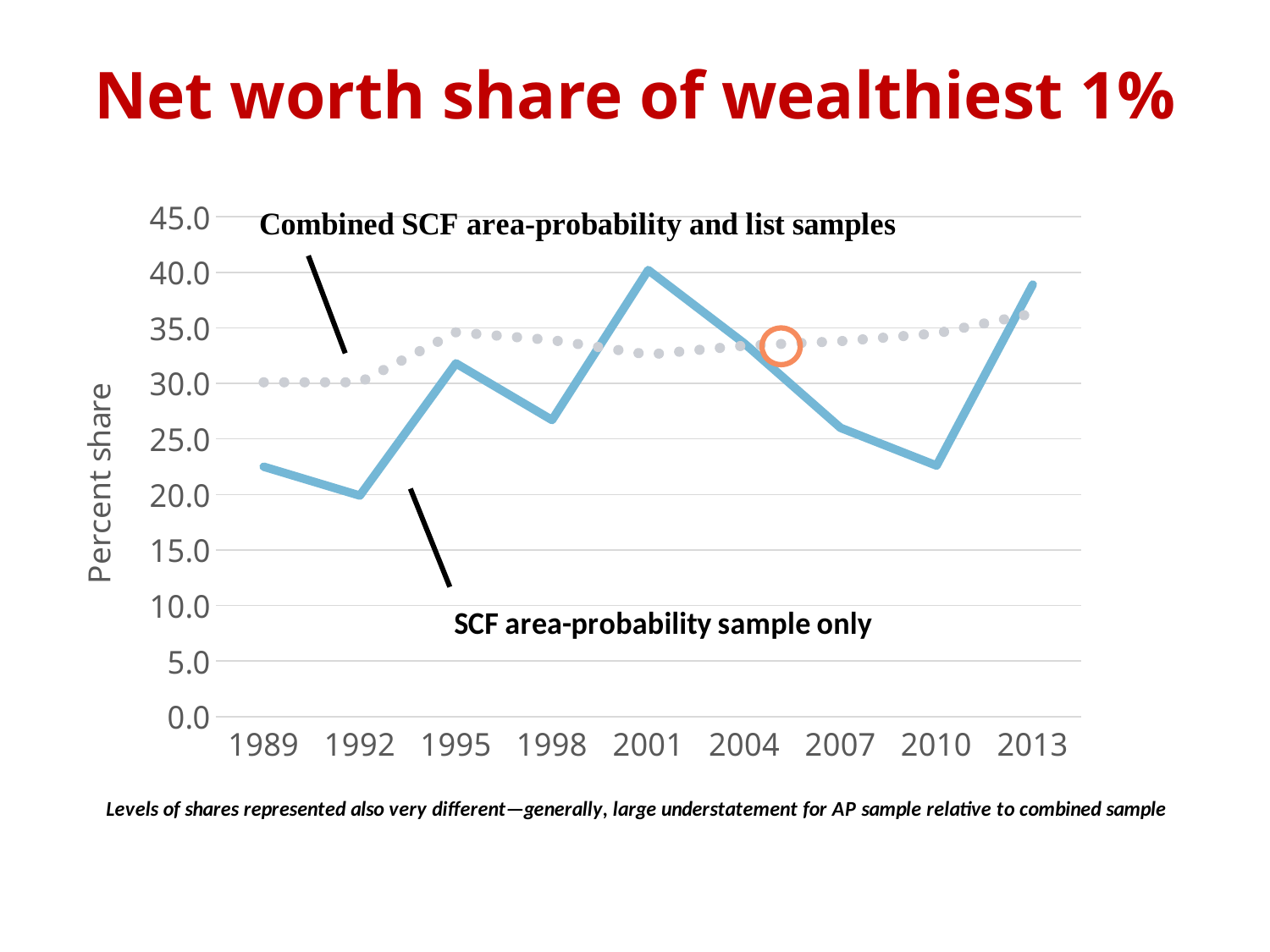
What is the title of the chart? Net worth share of wealthiest 1% What is the label on the vertical axis? Percent share What kind of chart is shown on the slide? line chart How many data series are plotted on the chart? 2 In which year does the 'SCF area-probability sample only' series reach its lowest value? 1992 How many years are plotted along the x axis? 9 In 2010, which series has the higher value: 'Combined SCF area-probability and list samples' or 'SCF area-probability sample only'? Combined SCF area-probability and list samples Is the value for the 'SCF area-probability sample only' series in 1992 greater or less than 25.0? less In which year does the 'Combined SCF area-probability and list samples' series reach its highest value? 2013 Is the value for the 'SCF area-probability sample only' series in 2001 greater or less than 35.0? greater In which year does the 'SCF area-probability sample only' series reach its highest value? 2001 In 2001, which series has the higher value: 'Combined SCF area-probability and list samples' or 'SCF area-probability sample only'? SCF area-probability sample only